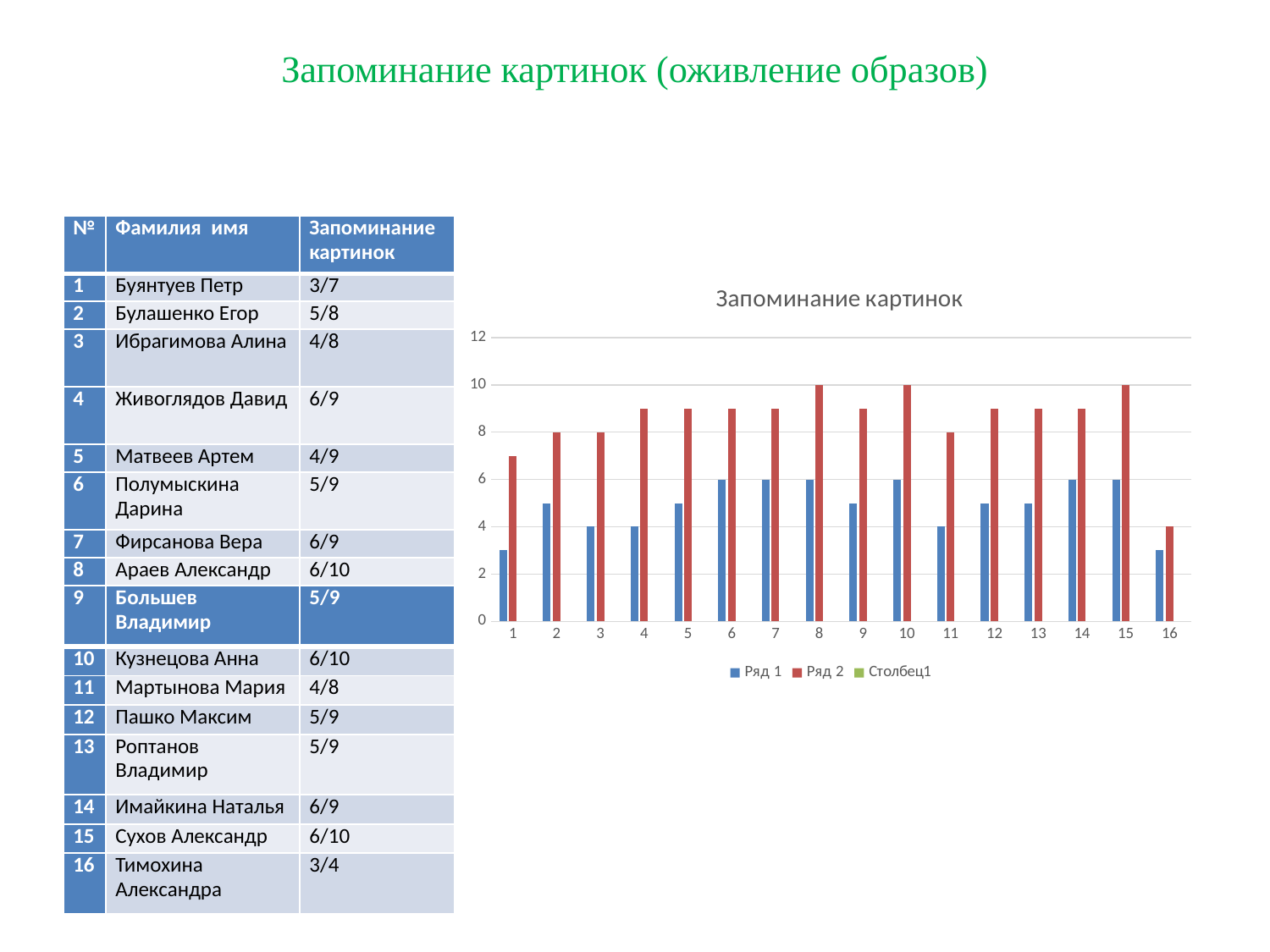
What is the value of Ряд 2 for category 8? 10 What is the value of Ряд 2 for category 16? 4 What is the difference between Ряд 2 and Ряд 1 for category 8? 4 For category 8, which series has the larger value, Ряд 1 or Ряд 2? Ряд 2 What is the value of Ряд 1 for category 4? 4 How many categories are shown along the x axis of the chart? 16 Which category has the lowest value for Ряд 2? 16 What is the value of Ряд 2 for category 11? 8 What kind of chart is shown on the slide? bar chart Is the value of Ряд 2 for category 1 greater or less than 6? greater How many series does the chart legend list? 3 Is the value of Ряд 1 for category 1 greater or less than 4? less